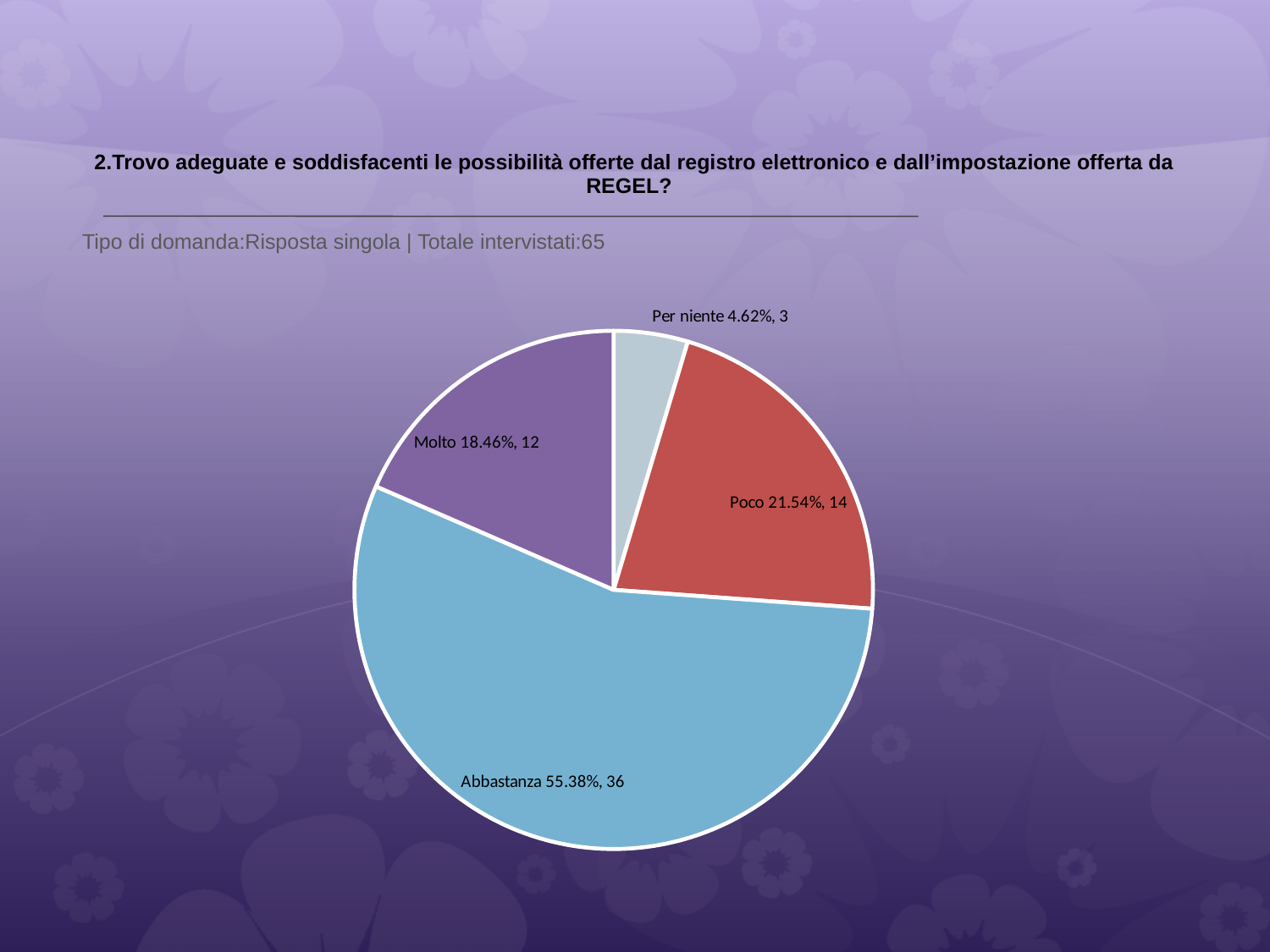
Which response category has the largest slice? Abbastanza What is the difference in respondent count between 'Abbastanza' and 'Poco'? 22 How many slices does the pie chart have? 4 What percentage share does the 'Abbastanza' slice have? 55.38% Which has more respondents, 'Poco' or 'Molto'? Poco How many respondents answered 'Poco'? 14 How many respondents answered 'Molto'? 12 What colour is the 'Abbastanza' slice? blue Which response category has the smallest slice? Per niente What is the total number of respondents shown on the slide? 65 What percentage share does the 'Per niente' slice have? 4.62% What kind of chart is shown on the slide? pie chart